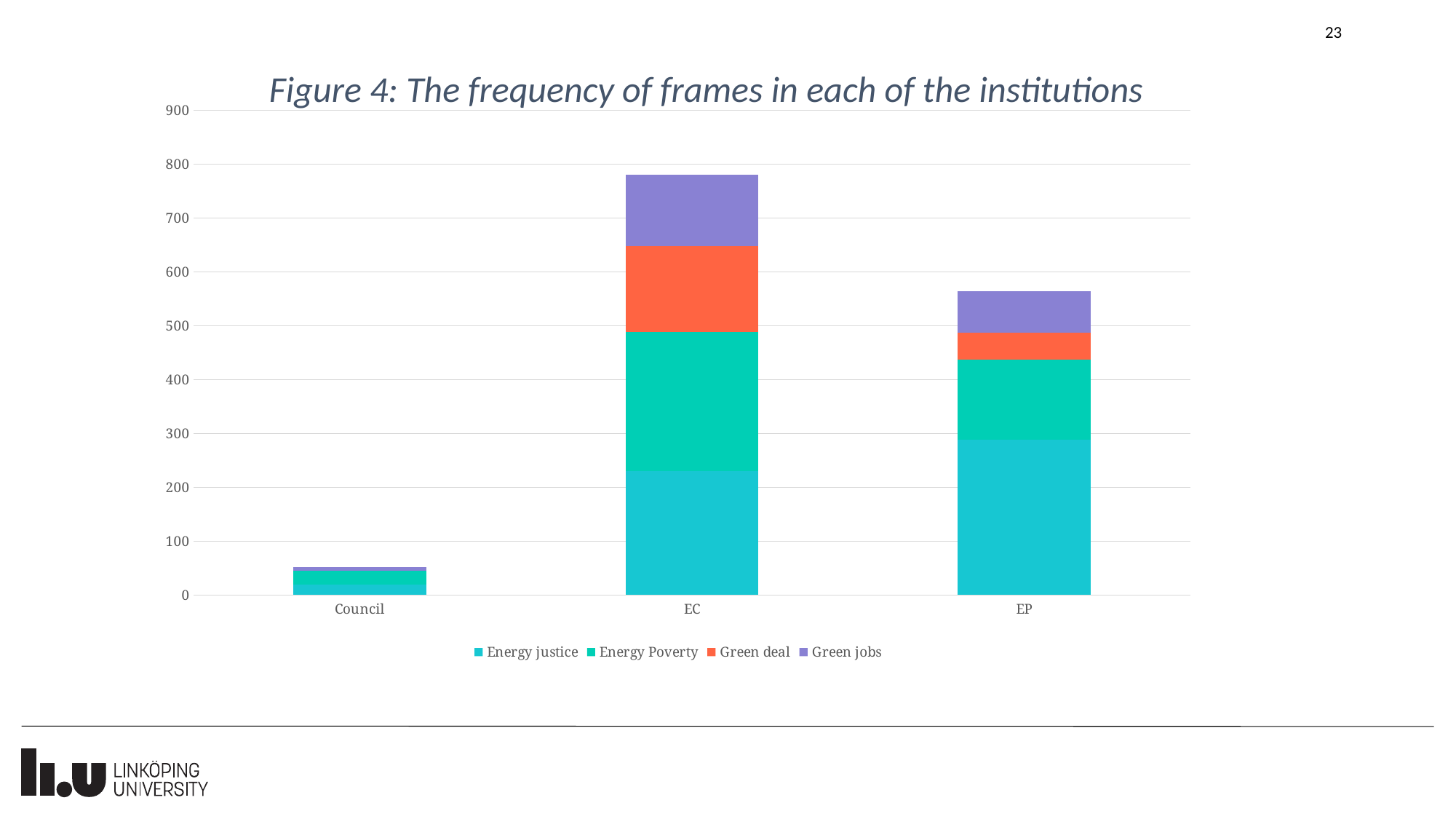
How many institutions (categories) are shown on the x axis? 3 Is the total bar height for EP greater or less than 600? less What is the title of the chart? Figure 4: The frequency of frames in each of the institutions What kind of chart is shown on the slide? stacked bar chart Which institution has the shortest stacked bar overall? Council Is the total bar height for Council greater or less than 100? less Is the total bar height for EC greater or less than 700? greater Which institution has the tallest stacked bar overall? EC How many series does the legend list? 4 Which has a larger total bar, EP or Council? EP Which series is listed first in the legend? Energy justice